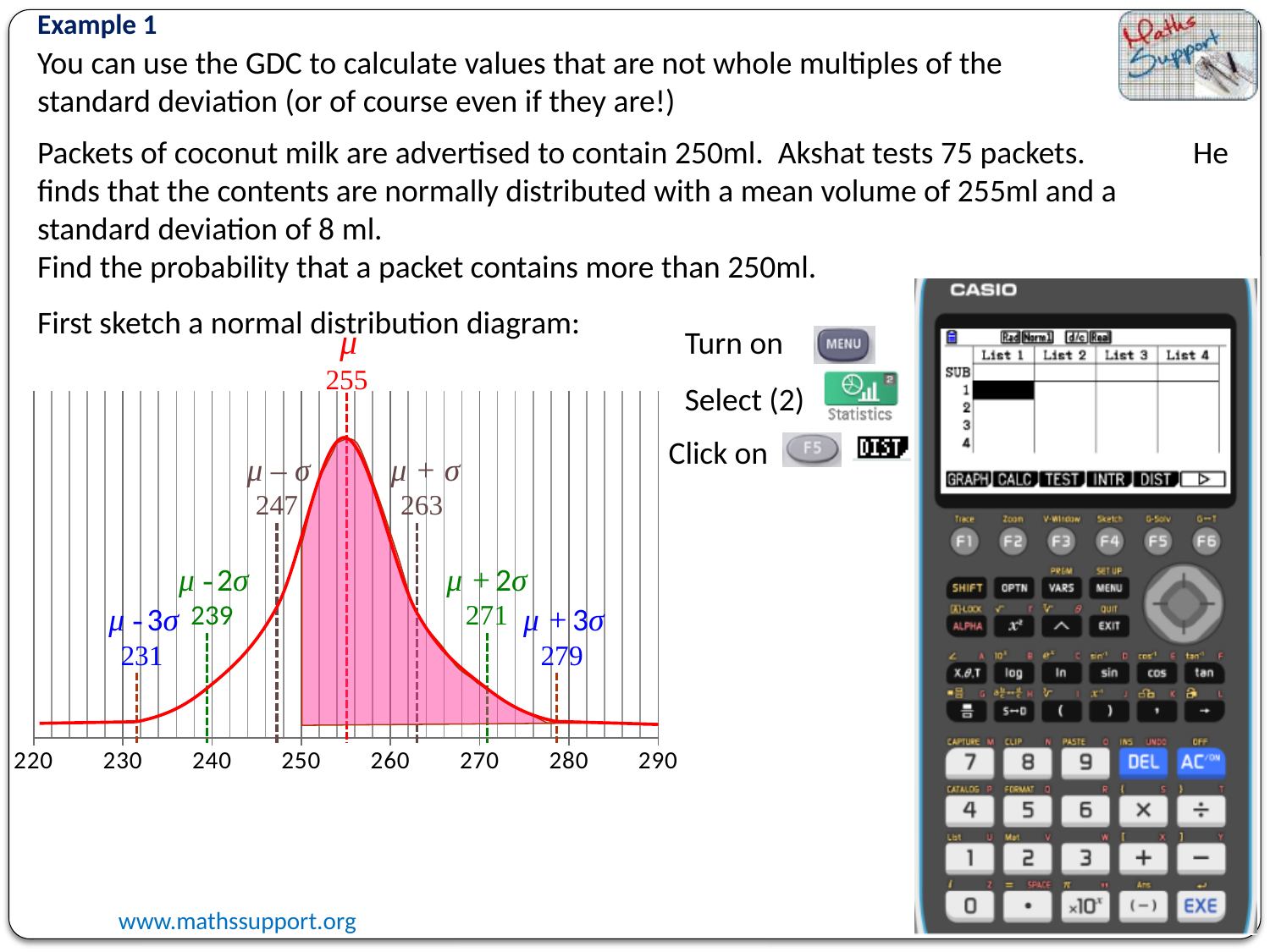
What value is labelled at μ − 2σ on the diagram? 239 What is the difference between the values labelled at μ + 3σ and μ − 3σ? 48 What value is labelled at μ − σ on the diagram? 247 What value is labelled at μ + σ on the diagram? 263 What value is labelled at μ + 3σ on the diagram? 279 What value is labelled at μ − 3σ on the diagram? 231 What is the lowest value shown on the horizontal axis of the diagram? 220 What is the difference between the values labelled at μ + σ and μ − σ? 16 What value is labelled at the mean μ on the normal distribution diagram? 255 Which is larger, the value labelled at μ + 2σ or the value labelled at μ − 2σ? μ + 2σ At what x-axis value does the pink shaded region under the curve begin? 250 What is the highest value shown on the horizontal axis of the diagram? 290